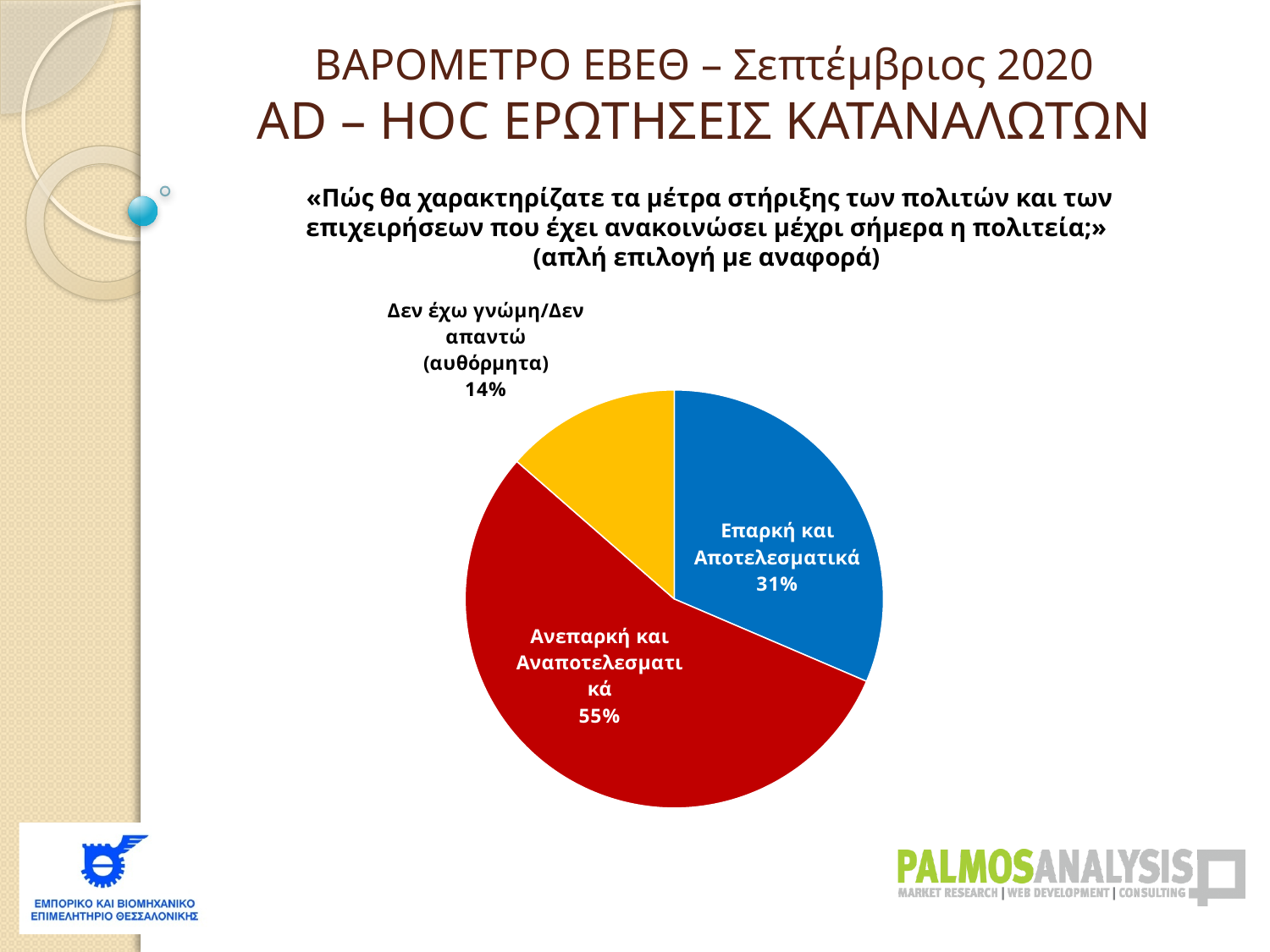
What colour is the slice for "Ανεπαρκή και Αναποτελεσματικά"? red What colour is the slice for "Επαρκή και Αποτελεσματικά"? blue What kind of chart is shown on the slide? pie chart What is the combined share of "Επαρκή και Αποτελεσματικά" and "Δεν έχω γνώμη/Δεν απαντώ (αυθόρμητα)"? 45% What share of respondents answered "Επαρκή και Αποτελεσματικά"? 31% Which slice of the pie is the largest? Ανεπαρκή και Αναποτελεσματικά How many slices does the pie chart have? 3 What is the difference in percentage points between "Ανεπαρκή και Αναποτελεσματικά" and "Επαρκή και Αποτελεσματικά"? 24 percentage points What share of respondents answered "Ανεπαρκή και Αναποτελεσματικά"? 55% Which slice of the pie is the smallest? Δεν έχω γνώμη/Δεν απαντώ (αυθόρμητα) Which is larger: the share for "Επαρκή και Αποτελεσματικά" or the share for "Δεν έχω γνώμη/Δεν απαντώ (αυθόρμητα)"? Επαρκή και Αποτελεσματικά What share of respondents answered "Δεν έχω γνώμη/Δεν απαντώ (αυθόρμητα)"? 14%